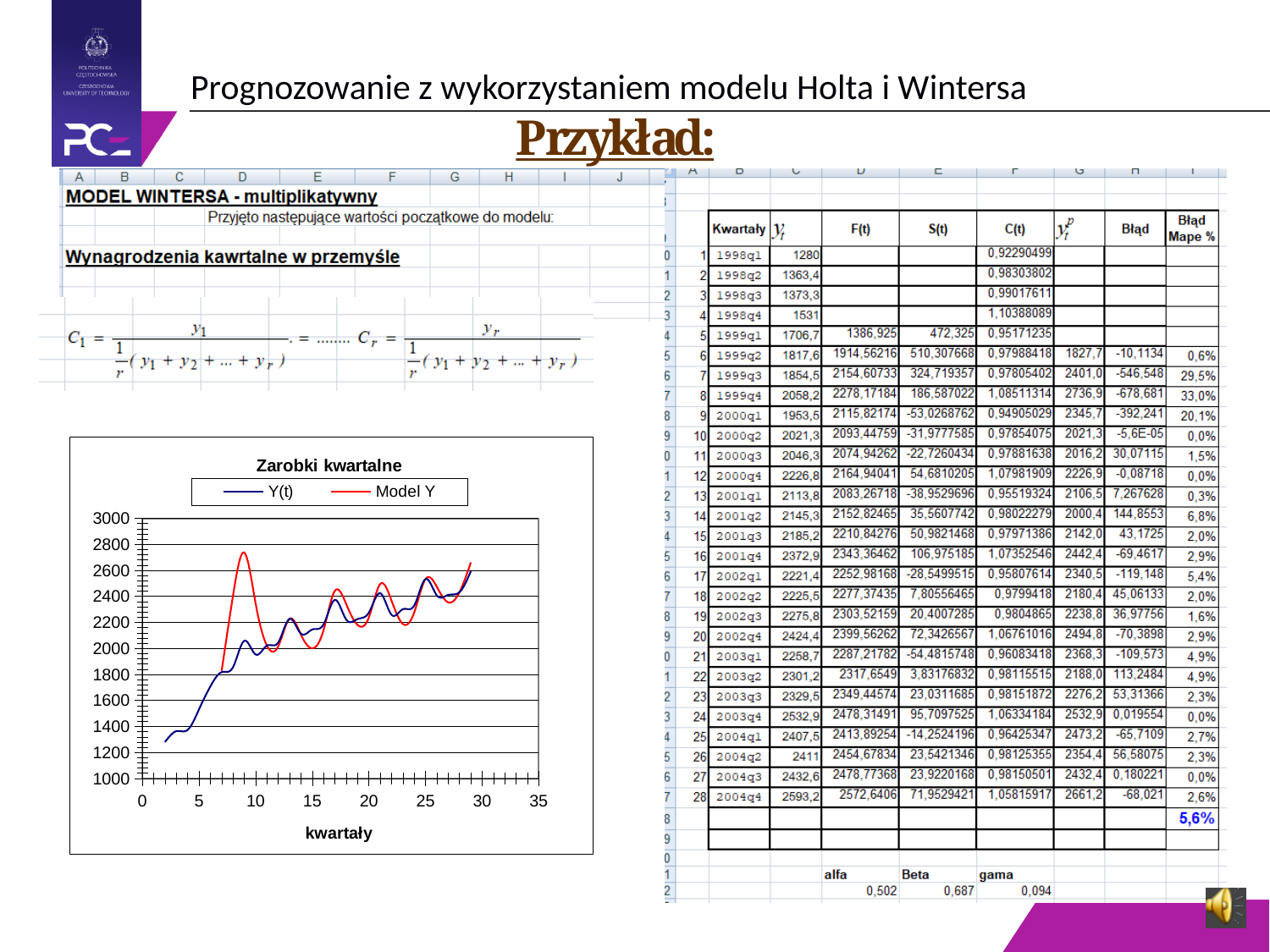
In the 'Zarobki kwartalne' chart, does the Y(t) series generally rise or fall along the x axis? rise What is the x-axis title of the 'Zarobki kwartalne' chart? kwartały What is the highest value shown on the y axis of the 'Zarobki kwartalne' chart? 3000 In the 'Zarobki kwartalne' chart, is the value of Y(t) at quarter 1 greater or less than 1400? less In the 'Zarobki kwartalne' chart, is the value of Y(t) at quarter 28 greater or less than 2400? greater What are the two series named in the legend of the 'Zarobki kwartalne' chart? Y(t) and Model Y What kind of chart is 'Zarobki kwartalne'? line chart In the 'Zarobki kwartalne' chart, at quarter 9 which series has the higher value, Y(t) or Model Y? Model Y How many series does the legend of the 'Zarobki kwartalne' chart list? 2 In the 'Zarobki kwartalne' chart, is the peak value of Model Y near quarter 9 greater or less than 2600? greater